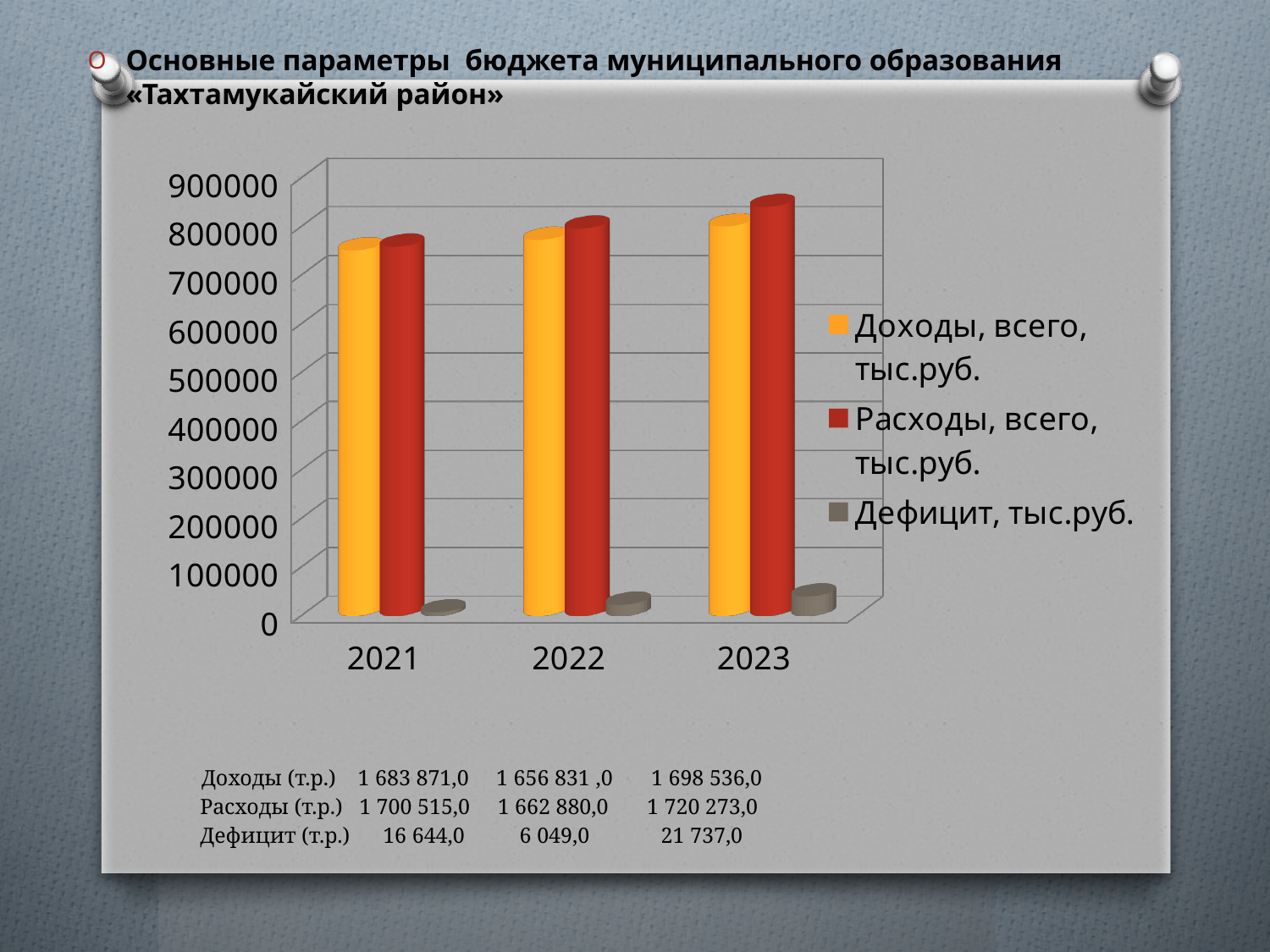
Is the value for Дефицит in 2023 greater or less than 100000? less How many years are shown on the x axis of the chart? 3 In which year is Доходы, всего the lowest? 2021 Is the value for Расходы, всего in 2023 greater or less than 800000? greater Which series is shown in yellow in the chart? Доходы, всего, тыс.руб. Do the values for Расходы, всего rise or fall from 2021 to 2023? rise How many series does the chart legend list? 3 Which series is shown in red in the chart? Расходы, всего, тыс.руб. In which year is Расходы, всего the highest? 2023 In 2023, which is larger: Доходы, всего or Расходы, всего? Расходы, всего Is the value for Доходы, всего in 2021 greater or less than 700000? greater What kind of chart is shown on the slide? bar chart